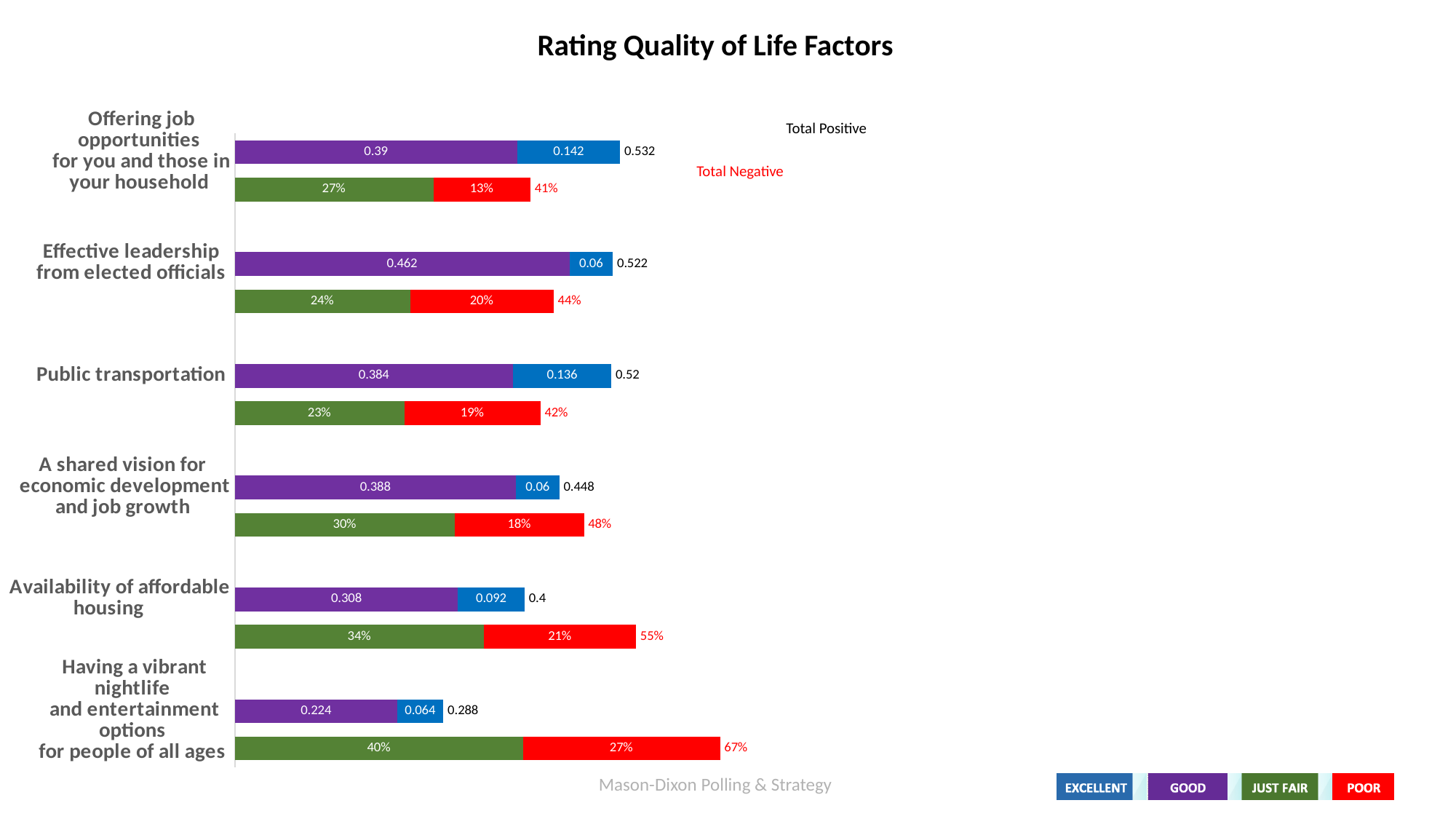
What is the Total Negative for A shared vision for economic development and job growth? 48% How many quality of life factors are shown on the chart? 6 What is the Poor value for Availability of affordable housing? 21% What is the Total Positive value for Effective leadership from elected officials? 0.522 What is the Good value for Public transportation? 0.384 What is the Excellent value for Having a vibrant nightlife and entertainment options for people of all ages? 0.064 Which is larger: the Poor value for Effective leadership from elected officials or the Poor value for Offering job opportunities? Effective leadership from elected officials Which category has the lowest Total Positive value? Having a vibrant nightlife and entertainment options for people of all ages How many series does the legend list? 4 Which category has the highest Total Negative value? Having a vibrant nightlife and entertainment options for people of all ages What is the difference between the Just Fair value for Having a vibrant nightlife (40%) and the Just Fair value for Public transportation (23%)? 17 percentage points What kind of chart is shown on the slide? Stacked bar chart